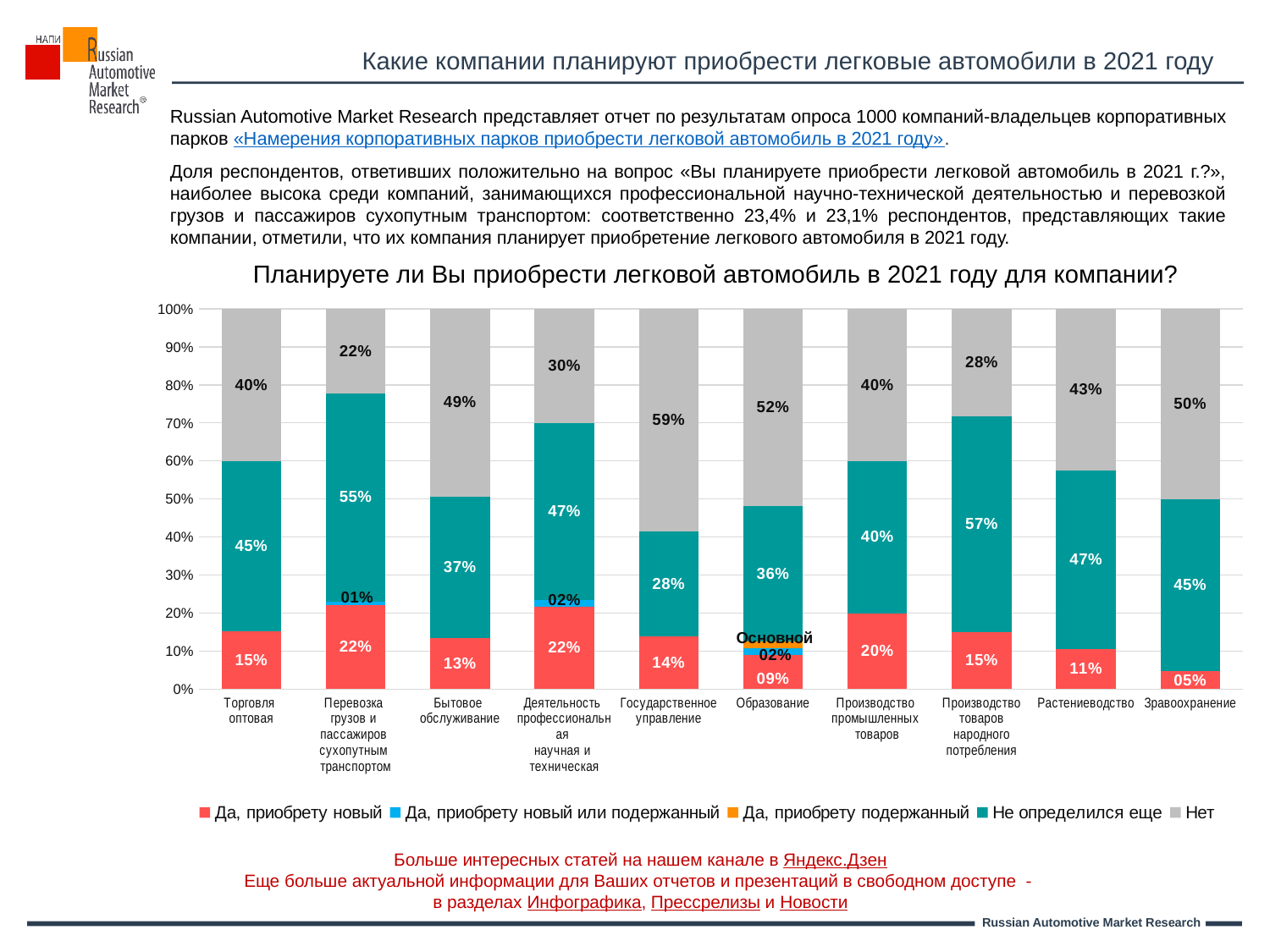
Which category has the lowest value for «Да, приобрету новый»? Зравоохранение How many categories are shown along the x axis? 10 Which is larger: «Не определился еще» for Торговля оптовая or for Растениеводство? Растениеводство What is the value of «Нет» for Государственное управление? 59% What is the value of «Да, приобрету новый или подержанный» for Деятельность профессиональная научная и техническая? 02% What is the title of the chart? Планируете ли Вы приобрести легковой автомобиль в 2021 году для компании? What kind of chart is shown on the slide? stacked bar chart What is the value of «Не определился еще» for Производство товаров народного потребления? 57% What is the difference between «Нет» for Здравоохранение and «Нет» for Перевозка грузов и пассажиров сухопутным транспортом? 28% How many series does the legend list? 5 What is the value of «Да, приобрету новый» for Бытовое обслуживание? 13% Which category has the highest value for «Нет»? Государственное управление